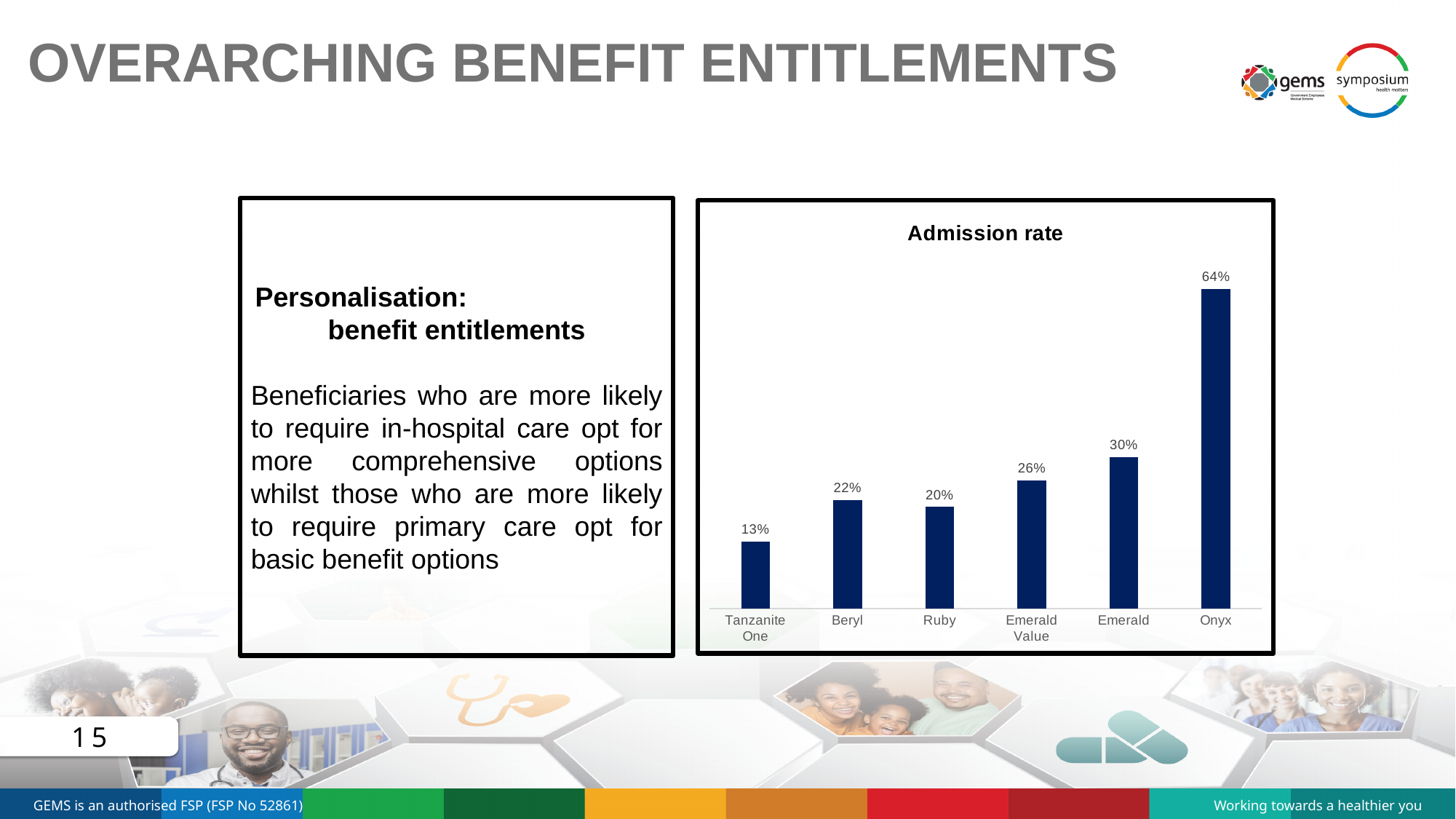
What is the difference between the admission rates of Onyx and Emerald? 34% What is the admission rate for Emerald Value? 26% What kind of chart is used to show the admission rate? Bar chart Which option has the highest admission rate? Onyx Which has a higher admission rate, Beryl or Ruby? Beryl What is the admission rate for Onyx? 64% What is the difference between the admission rates of Beryl and Ruby? 2% What is the title of the chart on the slide? Admission rate Which option has the lowest admission rate? Tanzanite One Which has a higher admission rate, Emerald or Emerald Value? Emerald What is the admission rate for Tanzanite One? 13% How many options are shown in the Admission rate chart? 6